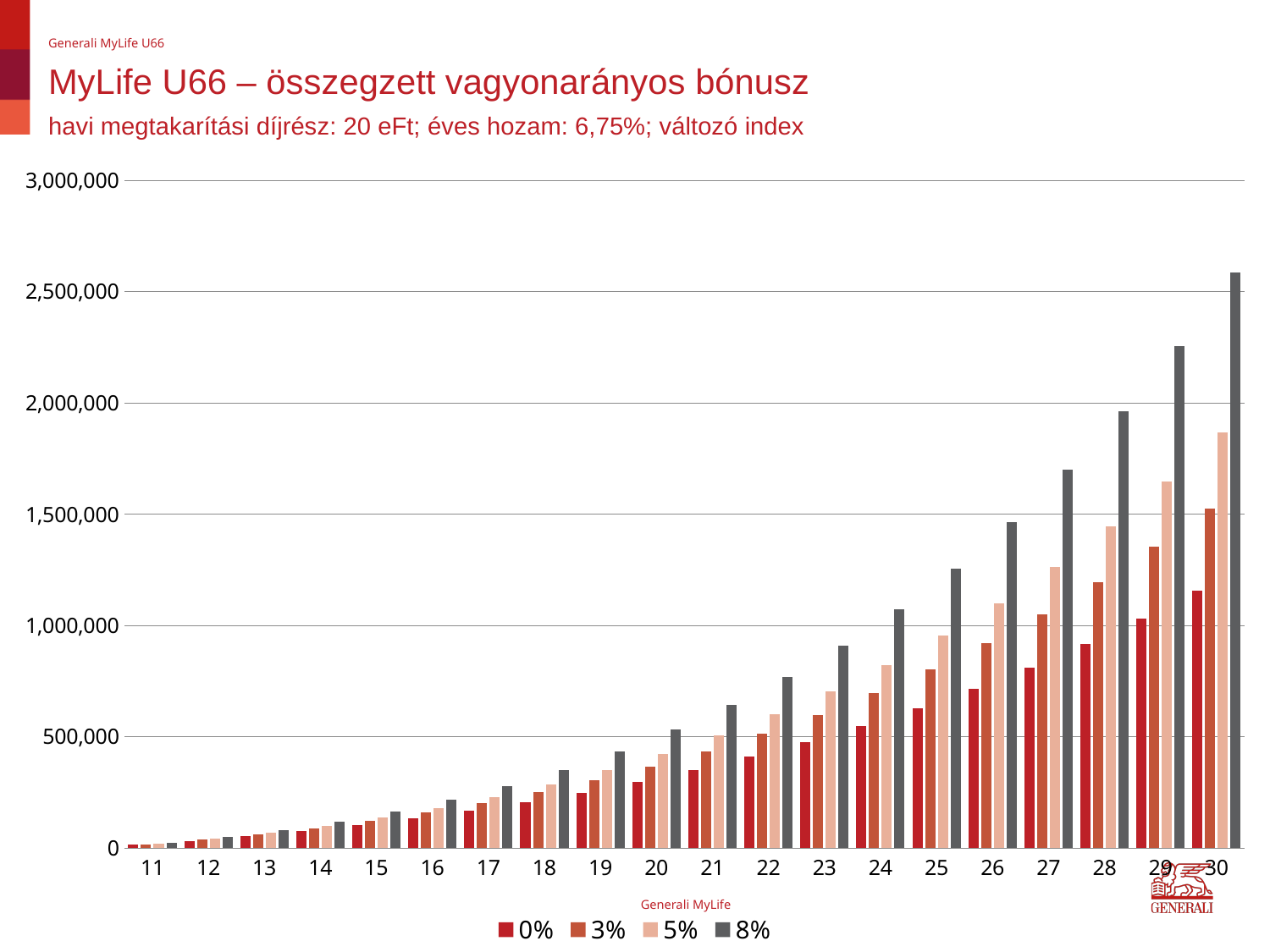
What are the legend entries of the chart? 0%, 3%, 5%, 8% Which series has the lowest bar at category 30? 0% Is the value for the 5% series at category 30 greater or less than 2,000,000? less What kind of chart is shown on the slide? bar chart Which series has the highest bar at category 30? 8% Do the values of the 8% series rise or fall from category 11 to category 30? rise How many series does the legend list? 4 Is the value for the 8% series at category 30 greater or less than 2,500,000? greater Which is larger at category 25: the 8% series or the 0% series? 8% How many categories are shown along the x axis? 20 Is the value for the 0% series at category 30 greater or less than 1,000,000? greater